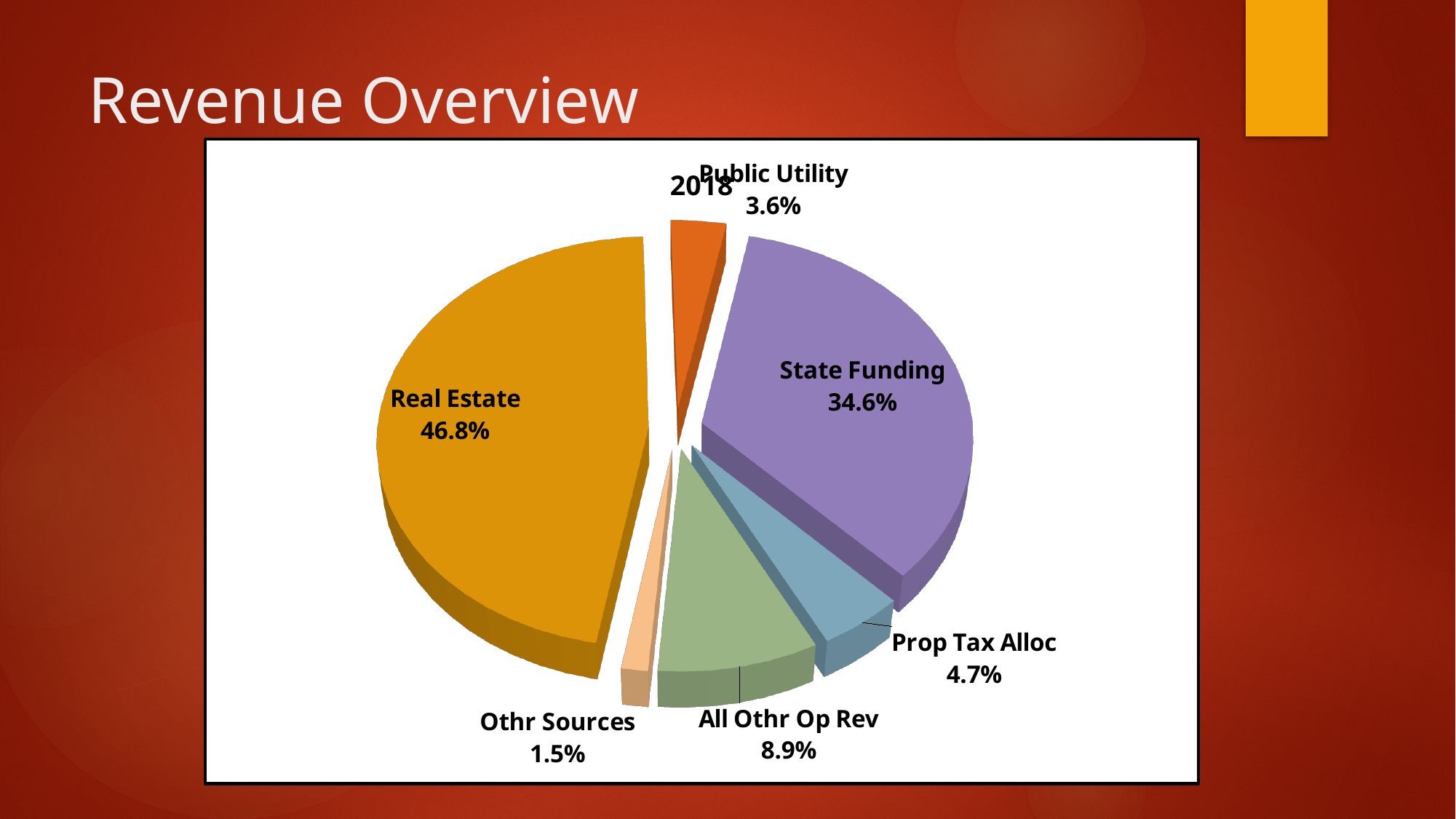
What colour is the State Funding slice? Purple What kind of chart is shown on the slide? Pie chart Which category has the largest slice of the pie? Real Estate Which category has the smallest slice of the pie? Othr Sources How many slices does the pie chart have? 6 What is the difference in percentage points between Real Estate and State Funding? 12.2 Which is larger, Prop Tax Alloc or Public Utility? Prop Tax Alloc What percentage is shown for State Funding? 34.6% What share of revenue does Real Estate account for? 46.8% What is the value for Public Utility? 3.6% What percentage is labelled for All Othr Op Rev? 8.9% What is the title of the chart? 2018